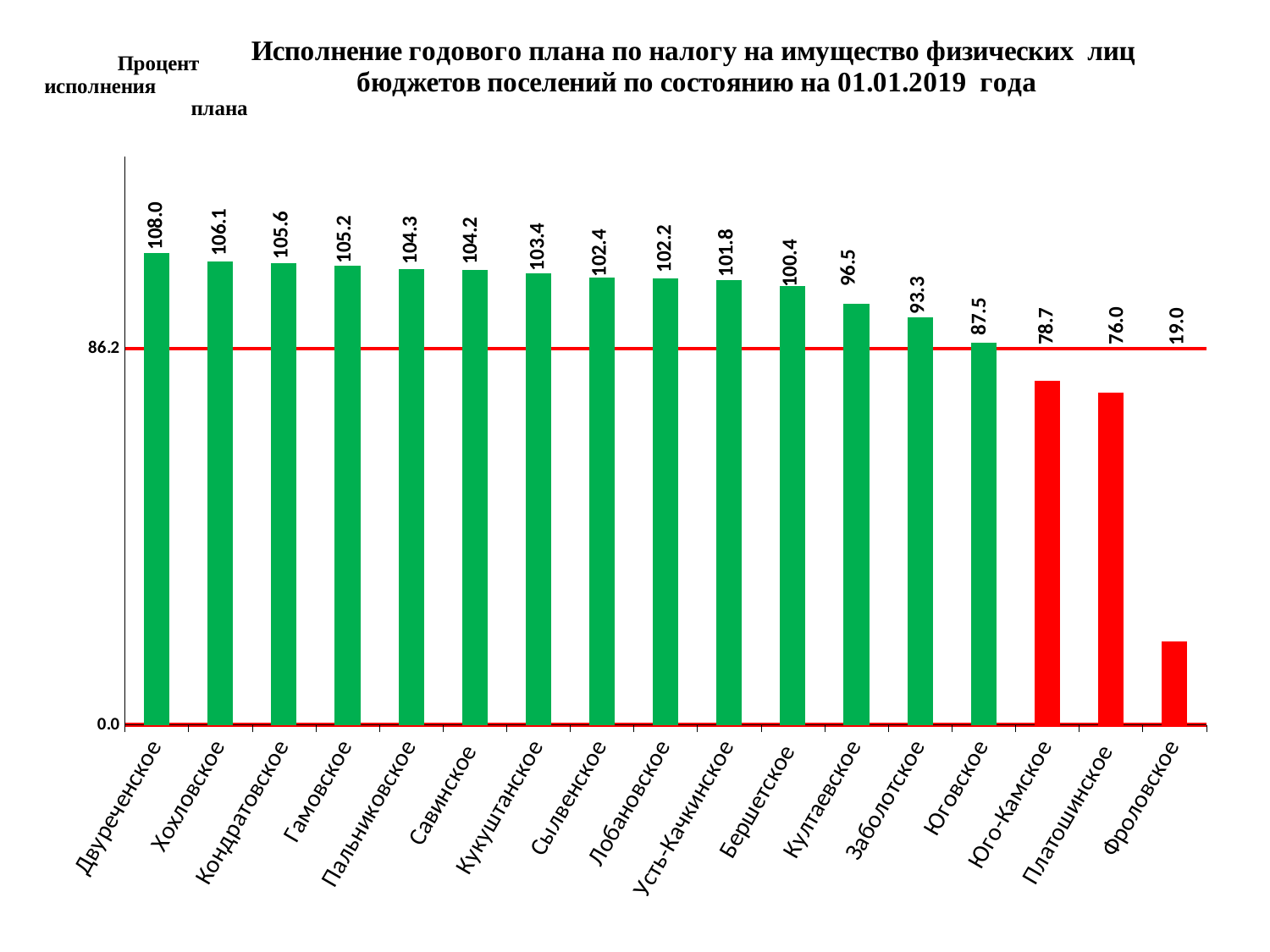
What is the value for Заболотское? 93.3 What is the difference between the values for Двуреченское and Фроловское? 89.0 Which is larger, the value for Култаевское or the value for Юговское? Култаевское Which category has the lowest value? Фроловское How many categories are shown on the x axis? 17 Which category has the highest value? Двуреченское What value is marked by the horizontal red line on the chart? 86.2 What is the value for Юго-Камское? 78.7 Do the values rise or fall from left to right along the x axis? fall What is the value for Двуреченское? 108.0 What is the difference between the values for Юго-Камское and Платошинское? 2.7 What kind of chart is this? bar chart